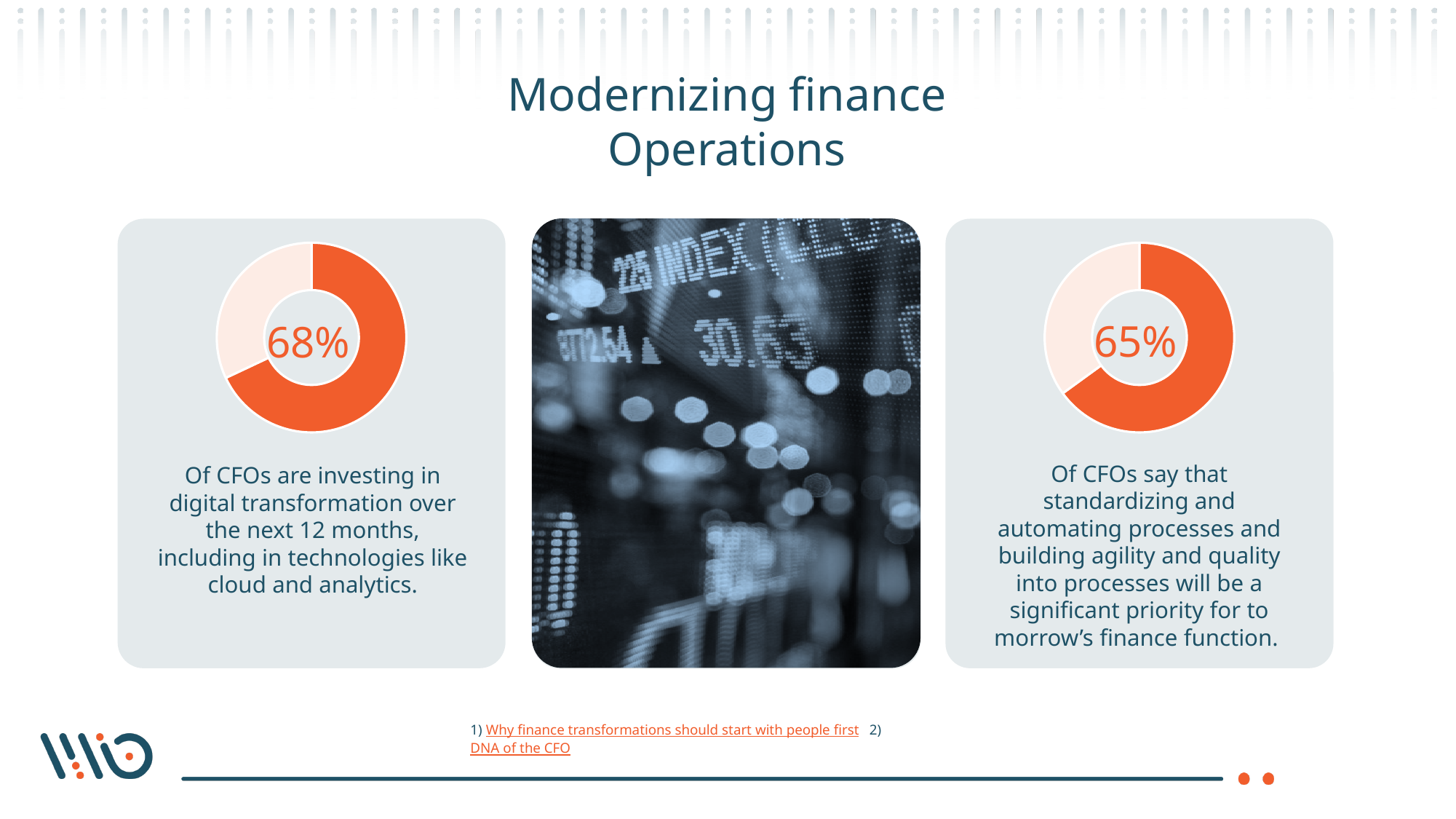
What colour is the filled segment in both donut charts? Orange What percentage is shown in the centre of the right donut chart? 65% Which donut chart shows the larger percentage, the left one or the right one? The left one How many donut charts are on the slide? 2 In the right donut chart, what share of the ring is filled by the dark orange segment? 65% What percentage is shown in the centre of the left donut chart? 68% What kind of chart is used on the right side of the slide? Donut chart In the left donut chart, what share of the ring is filled by the dark orange segment? 68% What is the difference between the percentage in the left donut chart and the percentage in the right donut chart? 3% Is the value shown in the right donut chart greater or less than 50%? greater What percentage of CFOs are investing in digital transformation over the next 12 months, according to the left donut chart? 68% What kind of chart is used on the left side of the slide? Donut chart